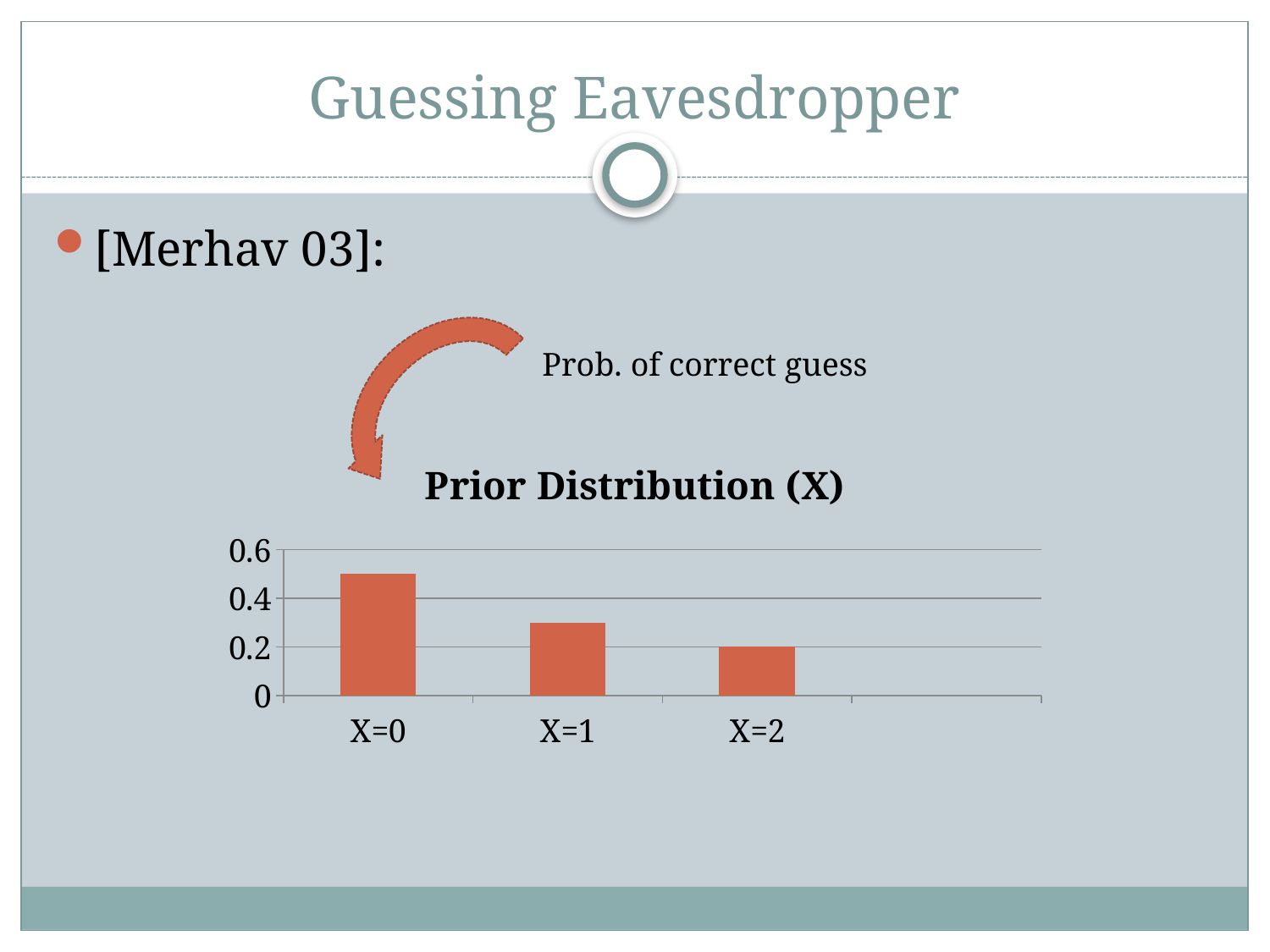
Is the value for X=0 greater or less than 0.4? greater Which is larger, the value for X=1 or the value for X=2? X=1 Which category has the lowest bar in the chart? X=2 Is the value for X=1 greater or less than 0.2? greater Is the value for X=1 greater or less than 0.4? less What is the value for X=2 in the chart? 0.2 What is the title of the chart? Prior Distribution (X) What kind of chart is shown on the slide? bar chart Do the bar values rise or fall from X=0 to X=2? fall Which category has the highest bar in the chart? X=0 How many categories are shown on the x axis of the chart? 3